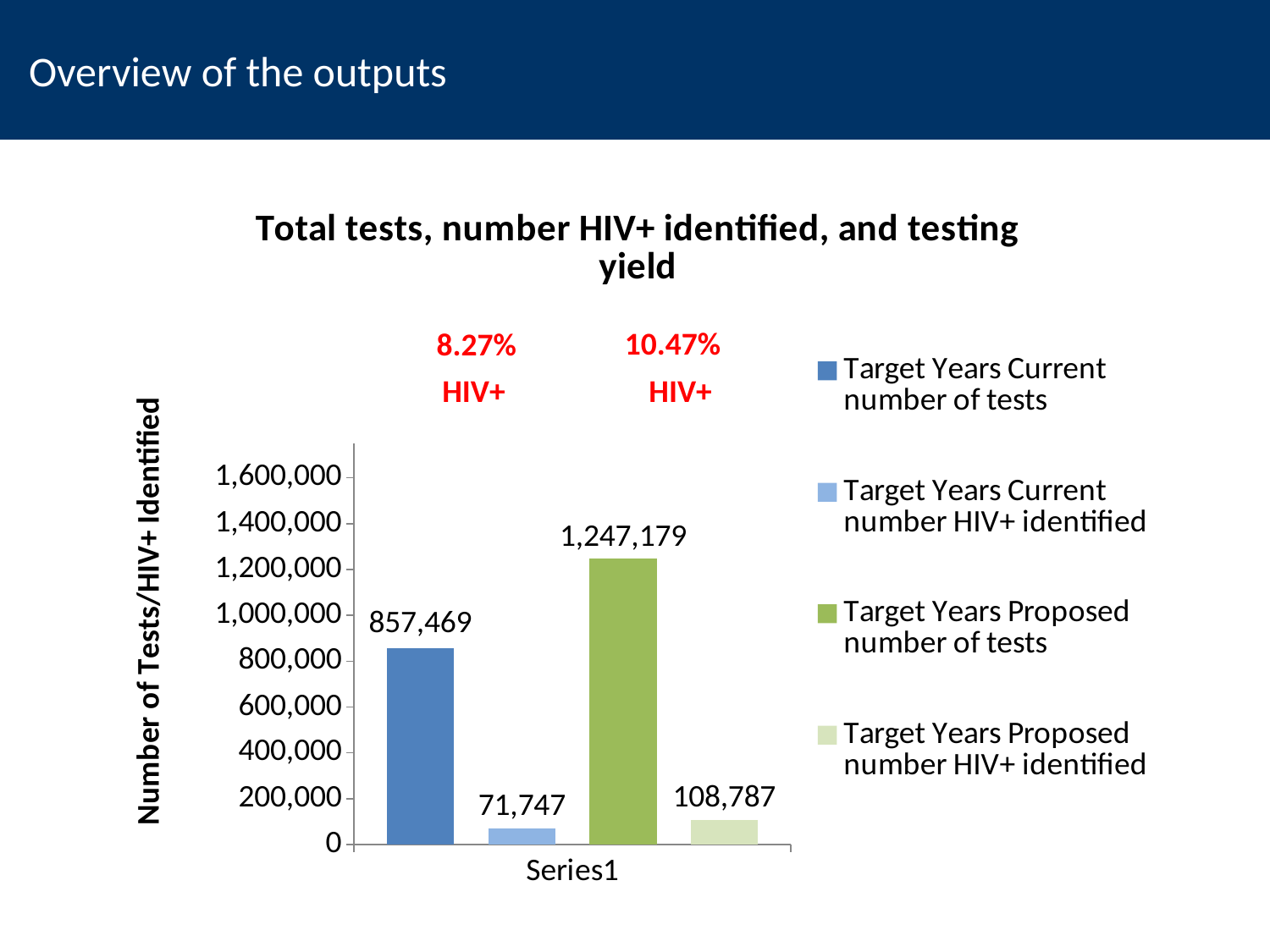
What is the title of the chart? Total tests, number HIV+ identified, and testing yield What kind of chart is shown? Bar chart What is the difference between Target Years Proposed number of tests and Target Years Current number of tests? 389,710 Which series has the highest value? Target Years Proposed number of tests What is the difference between Target Years Proposed number HIV+ identified and Target Years Current number HIV+ identified? 37,040 What is the value for Target Years Proposed number HIV+ identified? 108,787 What is the y-axis label of the chart? Number of Tests/HIV+ Identified What is the value for Target Years Current number of tests? 857,469 Which series has the lowest value? Target Years Current number HIV+ identified How many series does the legend list? 4 What is the value for Target Years Current number HIV+ identified? 71,747 Which is larger: Target Years Current number of tests or Target Years Proposed number of tests? Target Years Proposed number of tests